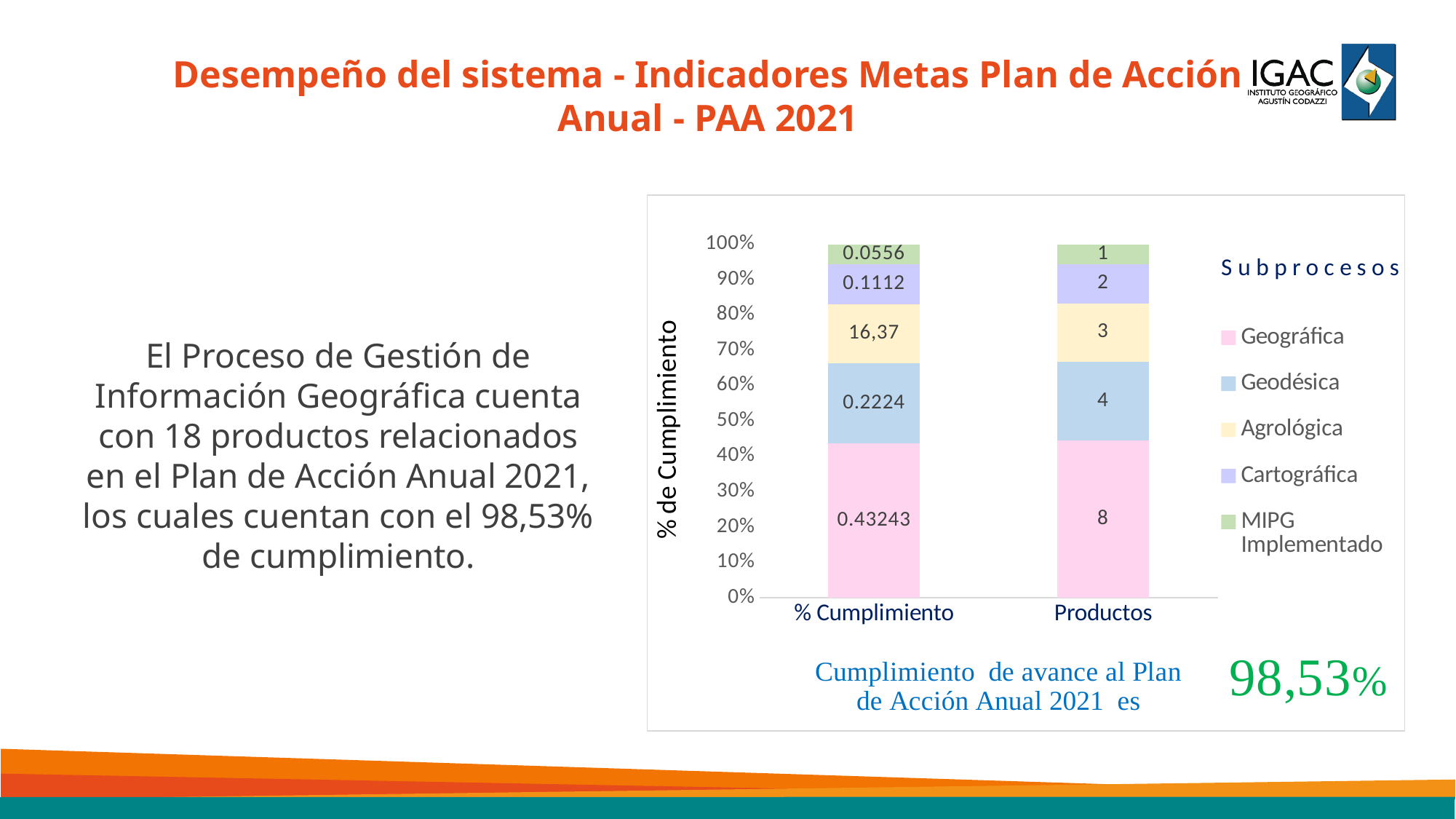
How many series does the chart legend list? 5 What kind of chart is shown on the slide? stacked bar chart What is the value for Agrológica in the % Cumplimiento bar? 16,37 What is the value for Geográfica in the Productos bar? 8 How many categories are shown on the x axis of the chart? 2 Which subprocess has the lowest value in the Productos bar? MIPG Implementado What is the value for Geográfica in the % Cumplimiento bar? 0.43243 What is the value for Geodésica in the Productos bar? 4 What is the difference between the Geográfica and Geodésica values in the Productos bar? 4 Which subprocess has the highest value in the Productos bar? Geográfica What is the value for MIPG Implementado in the % Cumplimiento bar? 0.0556 What is the total of the Productos stacked bar? 18